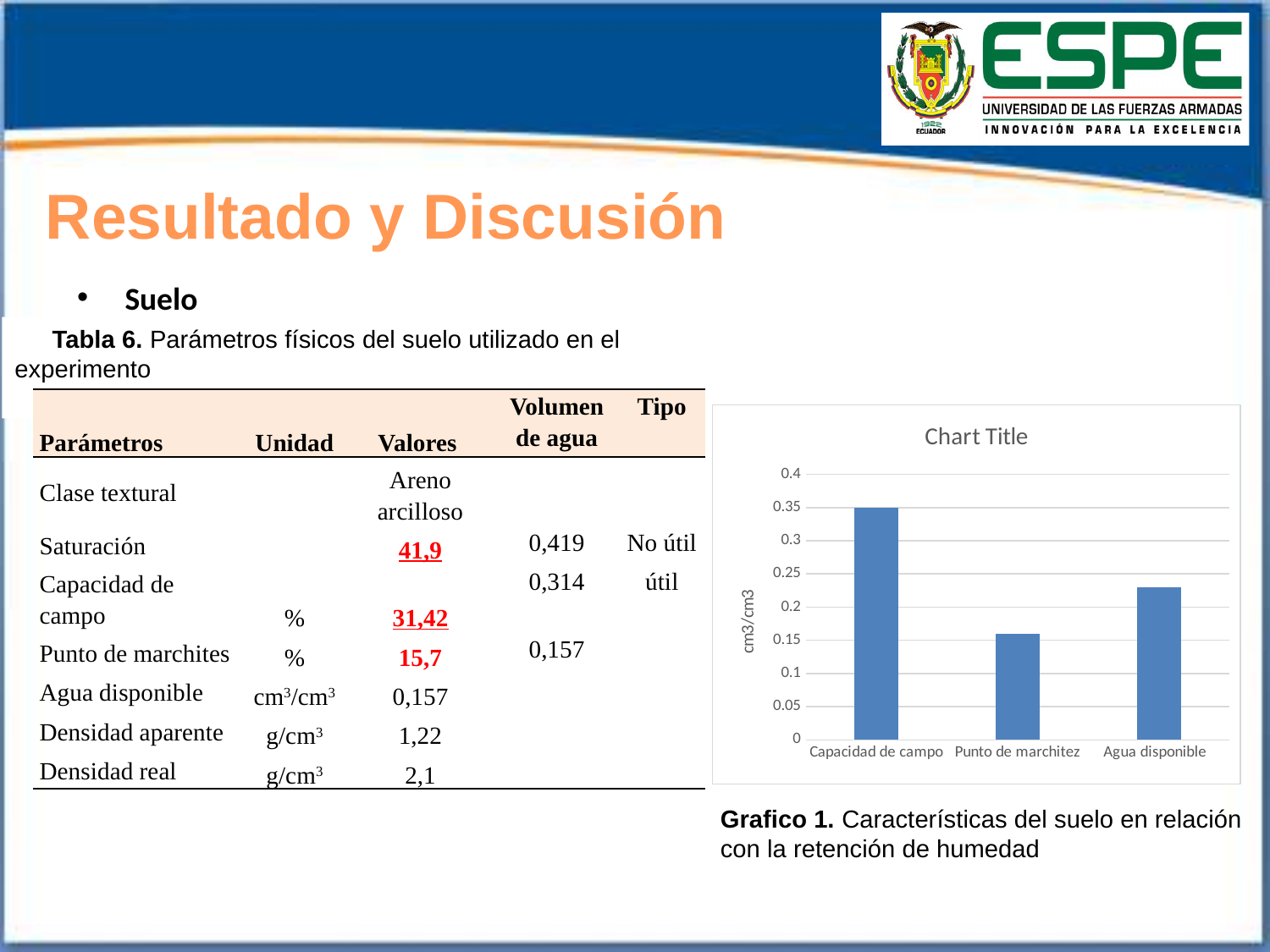
How many categories are plotted in the bar chart? 3 What kind of chart is shown on the slide? bar chart Which is larger in the chart, Agua disponible or Punto de marchitez? Agua disponible Is the value for Capacidad de campo greater or less than 0.3? greater Which category has the highest bar in the chart? Capacidad de campo Is the value for Agua disponible greater or less than 0.25? less Which is larger in the chart, Capacidad de campo or Agua disponible? Capacidad de campo Is the value for Agua disponible greater or less than 0.2? greater What is the label on the vertical axis of the chart? cm3/cm3 What title is displayed above the chart? Chart Title Which category has the lowest bar in the chart? Punto de marchitez